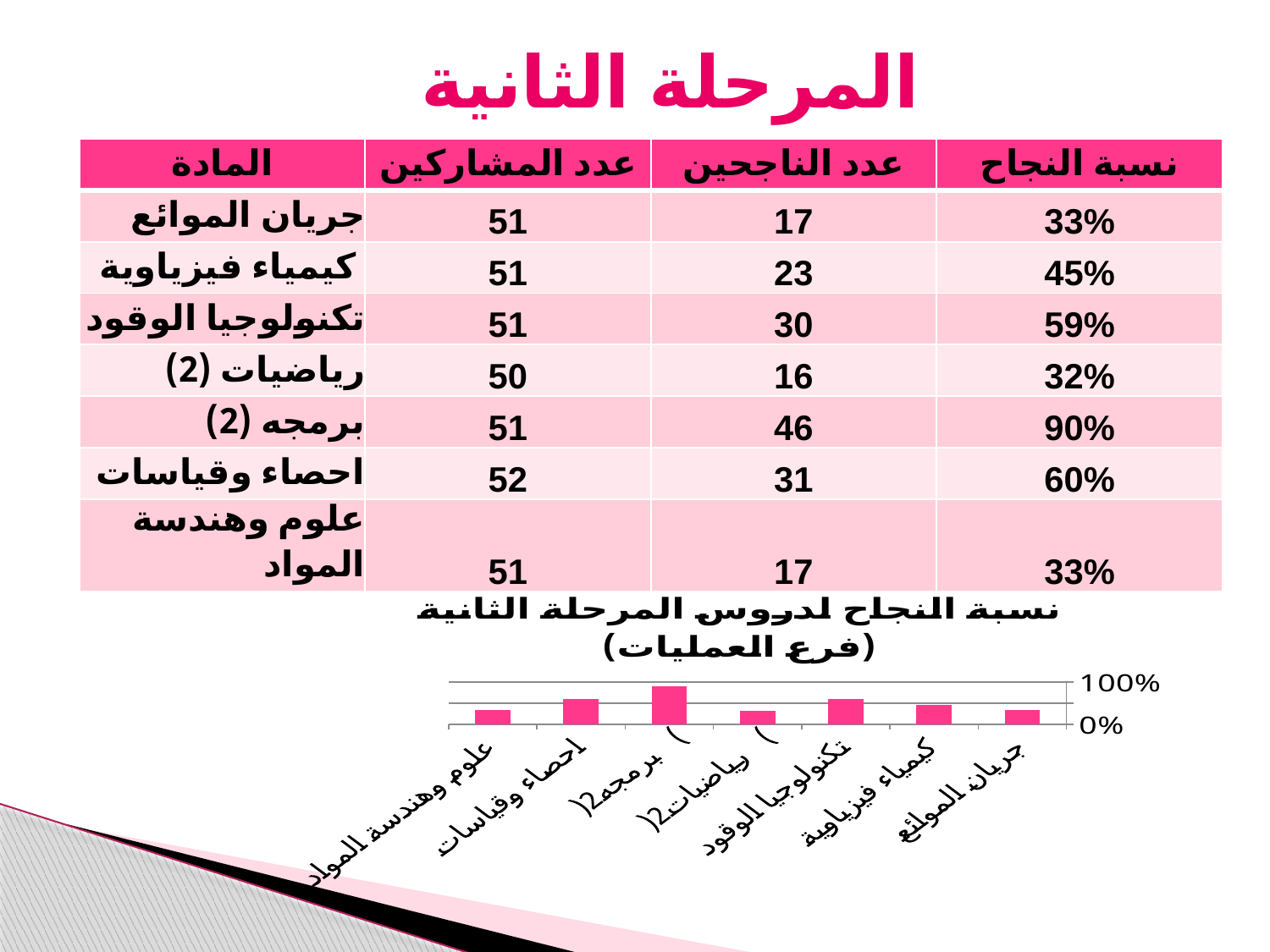
Which subject has the highest bar in the chart? برمجه (2) Which bar is taller, تكنولوجيا الوقود or جريان الموائع? تكنولوجيا الوقود How many categories (subjects) are plotted in the chart? 7 What is the success rate plotted for احصاء وقياسات? 60% What colour are the bars in the chart? pink What kind of chart is shown on the slide? bar chart Which bar is taller, برمجه (2) or رياضيات (2)? برمجه (2) What is the success rate plotted for تكنولوجيا الوقود? 59% What is the success rate plotted for كيمياء فيزياوية? 45% What is the difference between the success rates of برمجه (2) and رياضيات (2)? 58% What is the success rate plotted for برمجه (2)? 90% What is the title of the chart? نسبة النجاح لدروس المرحلة الثانية (فرع العمليات)